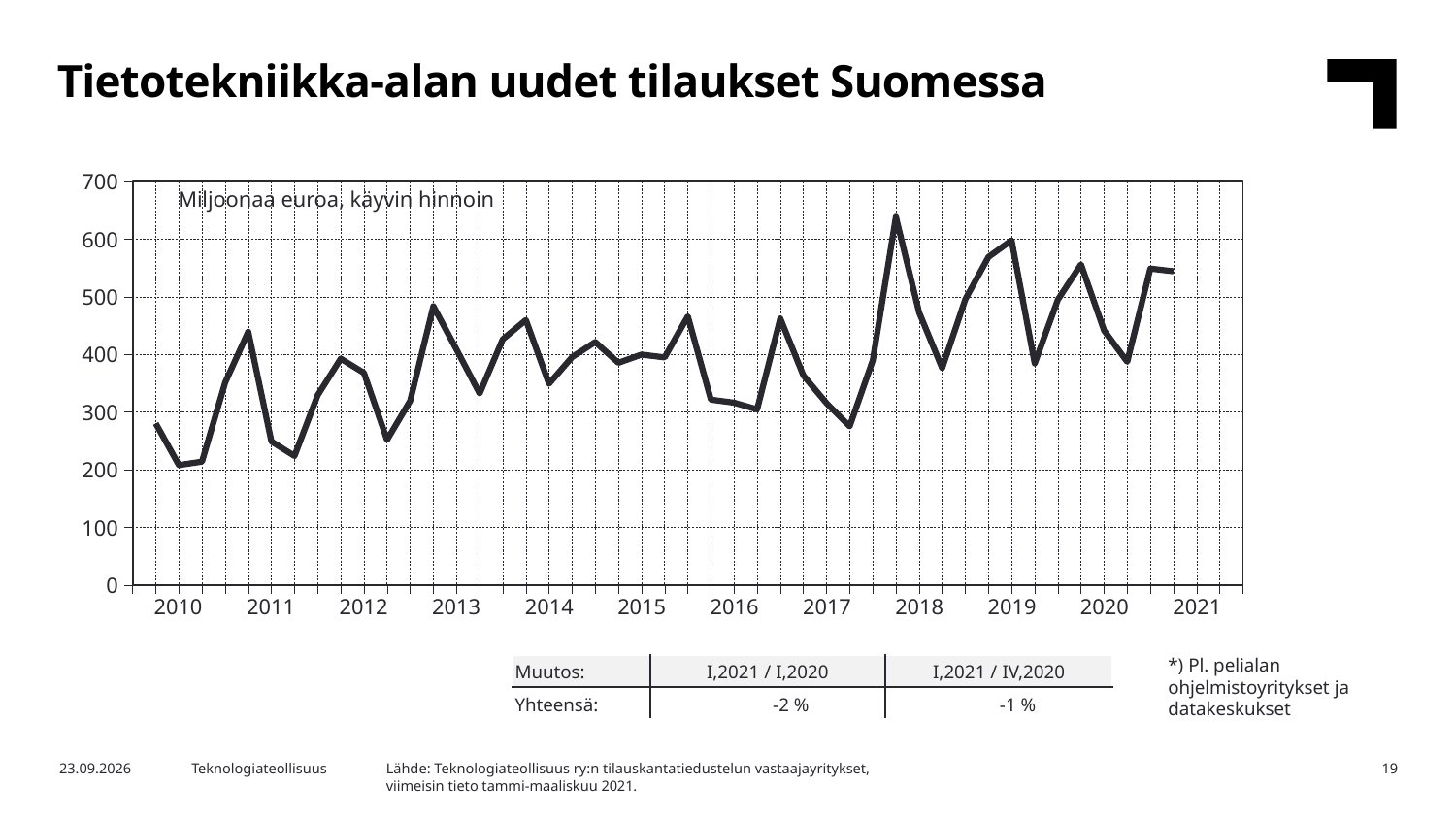
What unit is stated inside the chart area? Miljoonaa euroa, käyvin hinnoin Is the value at the last plotted point in 2021 greater or less than 500? greater Is the lowest point of the line in 2017 greater or less than 300? less What is the title of the chart on the slide? Tietotekniikka-alan uudet tilaukset Suomessa What kind of chart is shown on the slide? line chart Is the peak of the line in 2018 higher or lower than the peak in 2013? higher Is the lowest value of the line, in 2010, greater or less than 300? less In which year does the line reach its lowest point? 2010 How many years are labelled on the x axis of the chart? 12 According to the table below the chart, what is the change (Muutos) for I,2021 / I,2020? -2 % In which year does the line reach its highest point? 2018